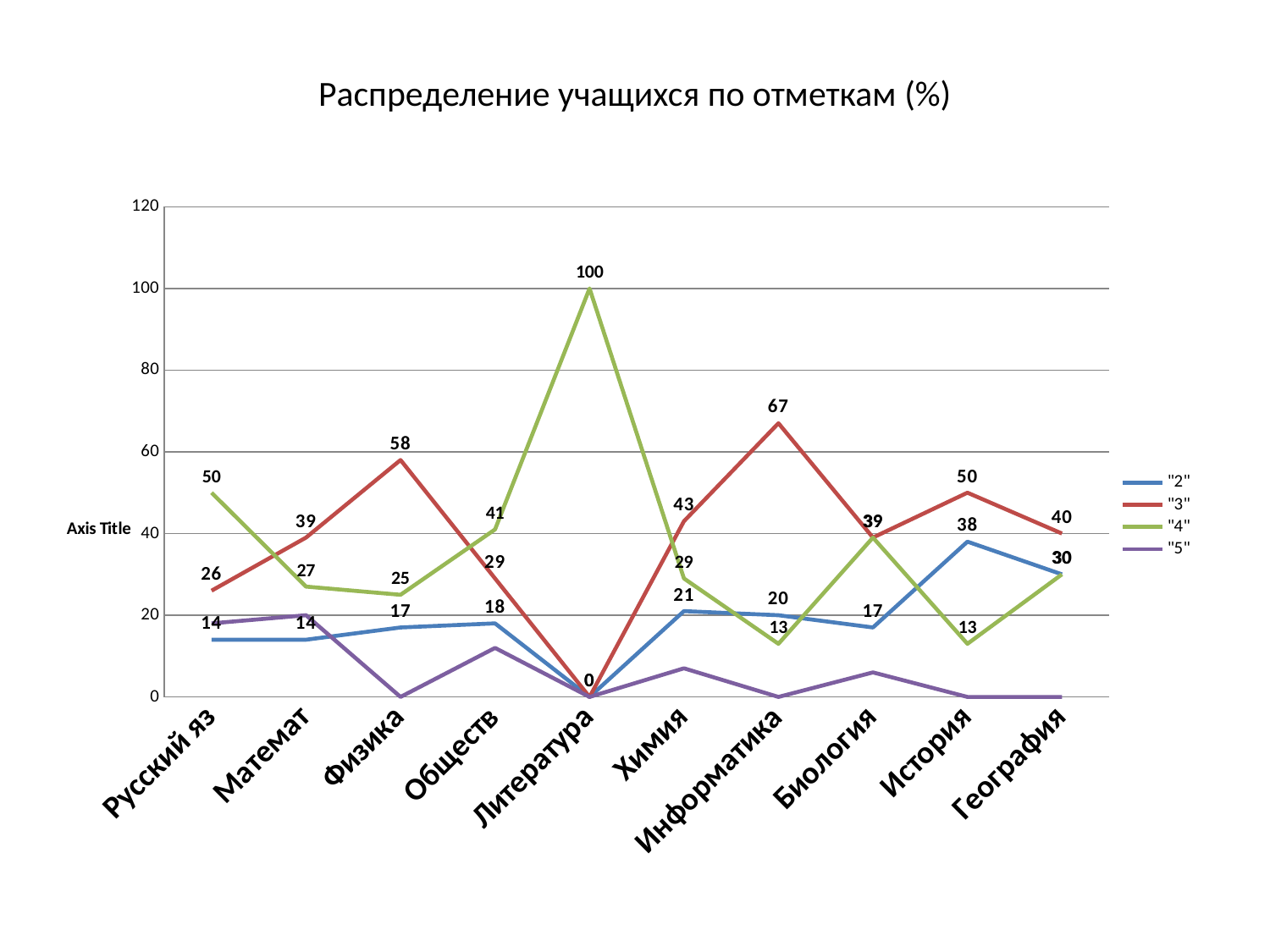
For Физика, what is the difference between series "3" and series "4"? 33 What is the value of series "3" for Информатика? 67 How many series does the legend list? 4 What is the value of series "4" for Литература? 100 For which subject does series "3" reach its highest value? Информатика For Русский яз, which is larger: series "4" or series "3"? "4" What kind of chart is shown on the slide? line chart What is the value of series "2" for История? 38 How many subjects (categories) are shown on the x axis? 10 Is the value of series "5" for Обществ greater or less than 20? less What is the title of the chart? Распределение учащихся по отметкам (%) For which subject does series "2" have its lowest value? Литература